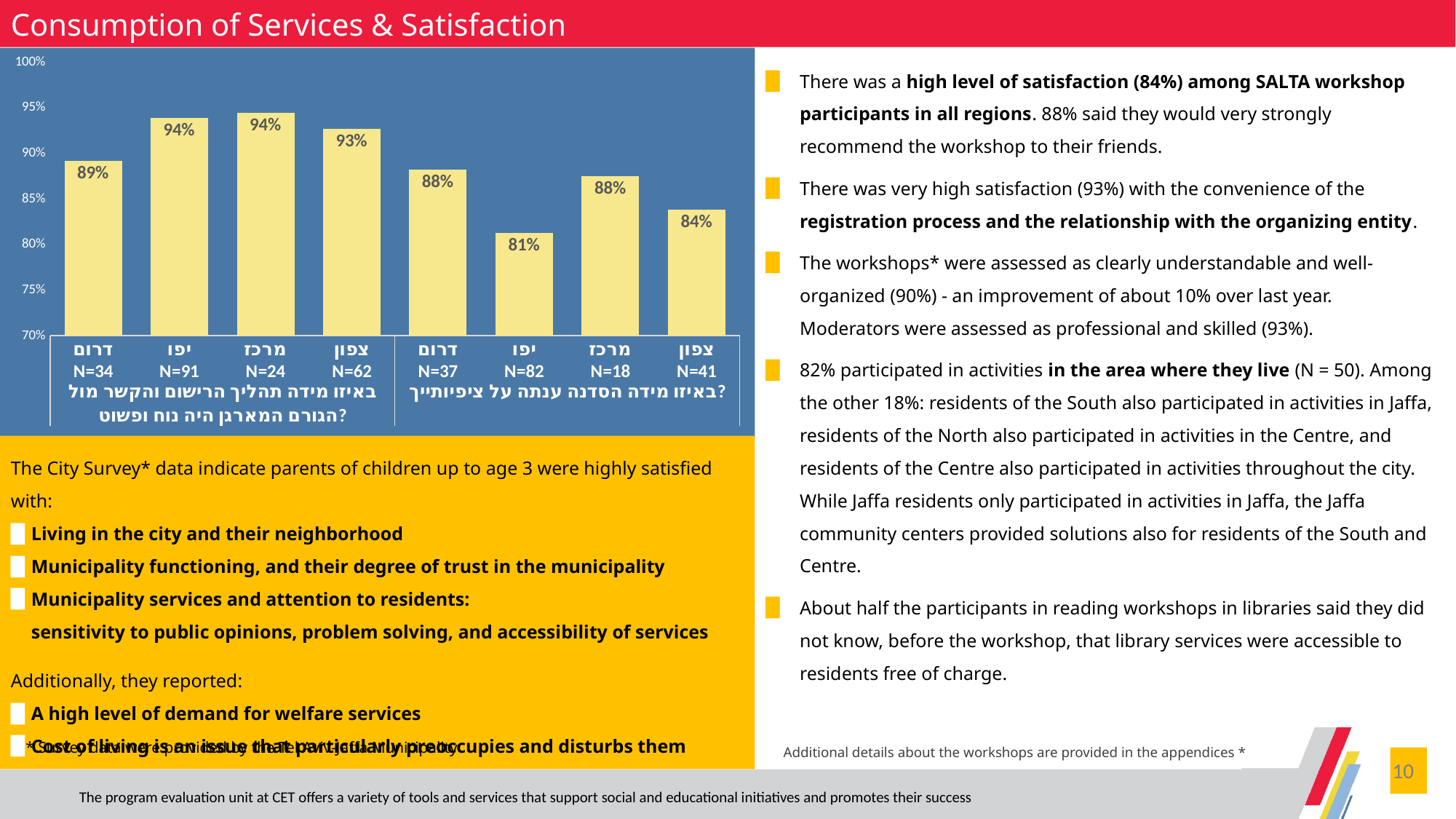
What is the lowest percentage shown on the chart's vertical axis? 70% How many bars are plotted in the chart? 8 What is the difference between the values for צפון N=62 and צפון N=41? 9% What is the value for the bar labelled צפון N=62? 93% What is the value for the bar labelled דרום N=34? 89% Which is larger, the value for דרום N=34 or the value for דרום N=37? דרום N=34 Which bar has the lowest value in the chart? יפו N=82 What is the value for the bar labelled צפון N=41? 84% Is the value for מרכז N=18 greater or less than 85%? greater What type of chart is shown on the slide? bar chart What is the value for the bar labelled יפו N=82? 81% What is the difference between the values for מרכז N=24 and יפו N=82? 13%